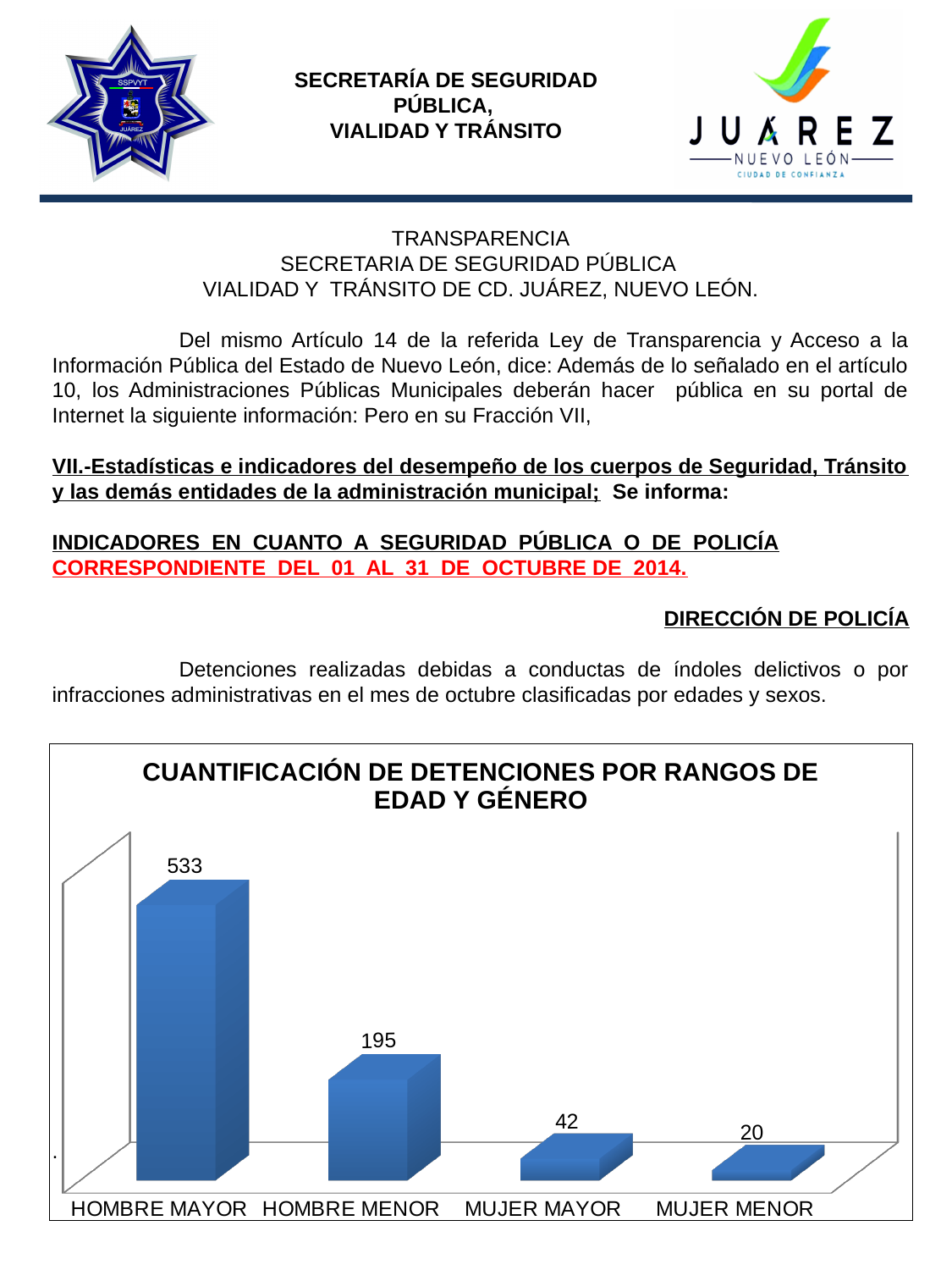
Which category has the lowest value? MUJER MENOR What is the value for MUJER MAYOR? 42 What is the value for HOMBRE MENOR? 195 What is the title of the chart? CUANTIFICACIÓN DE DETENCIONES POR RANGOS DE EDAD Y GÉNERO What is the value for HOMBRE MAYOR? 533 What is the difference between the values for HOMBRE MAYOR and HOMBRE MENOR? 338 Which category has the highest value? HOMBRE MAYOR What is the difference between the values for MUJER MAYOR and MUJER MENOR? 22 Which is larger, the value for HOMBRE MENOR or the value for MUJER MAYOR? HOMBRE MENOR What kind of chart is shown? bar chart What is the value for MUJER MENOR? 20 How many categories are shown on the chart? 4